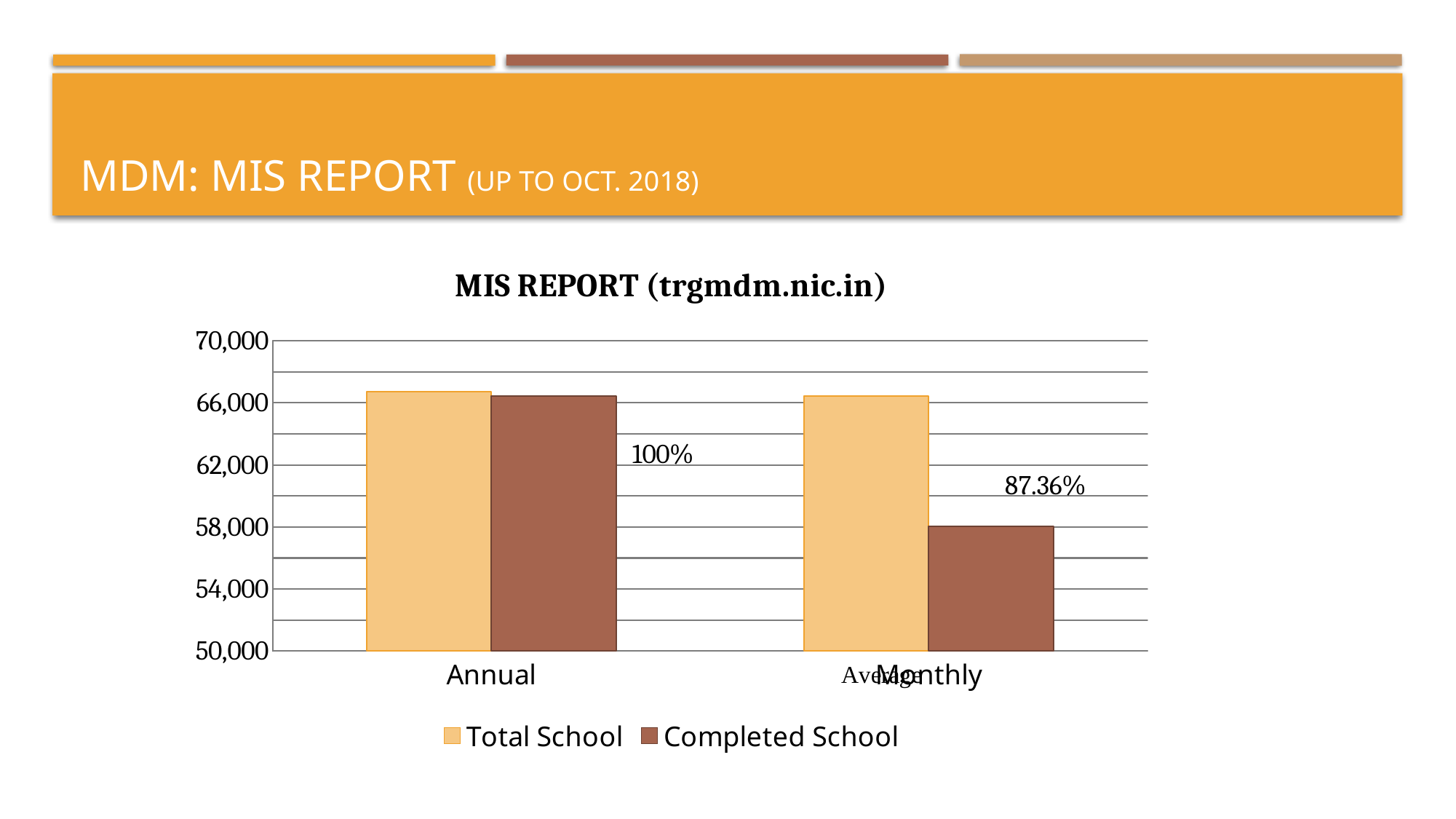
Does the Completed School value rise or fall from Annual to Monthly? fall What kind of chart is shown on the slide? bar chart Is the Completed School value for Monthly greater or less than 62,000? less For Monthly, which series has the larger value, Total School or Completed School? Total School What are the two series named in the legend? Total School and Completed School How many series does the legend list? 2 How many categories are shown on the x axis? 2 Which category has the lowest Completed School bar? Monthly Is the Total School value for Annual greater or less than 62,000? greater Is the Completed School value for Monthly greater or less than 54,000? greater What is the title of the chart? MIS REPORT (trgmdm.nic.in) Is the Completed School value for Annual larger or smaller than the Completed School value for Monthly? larger